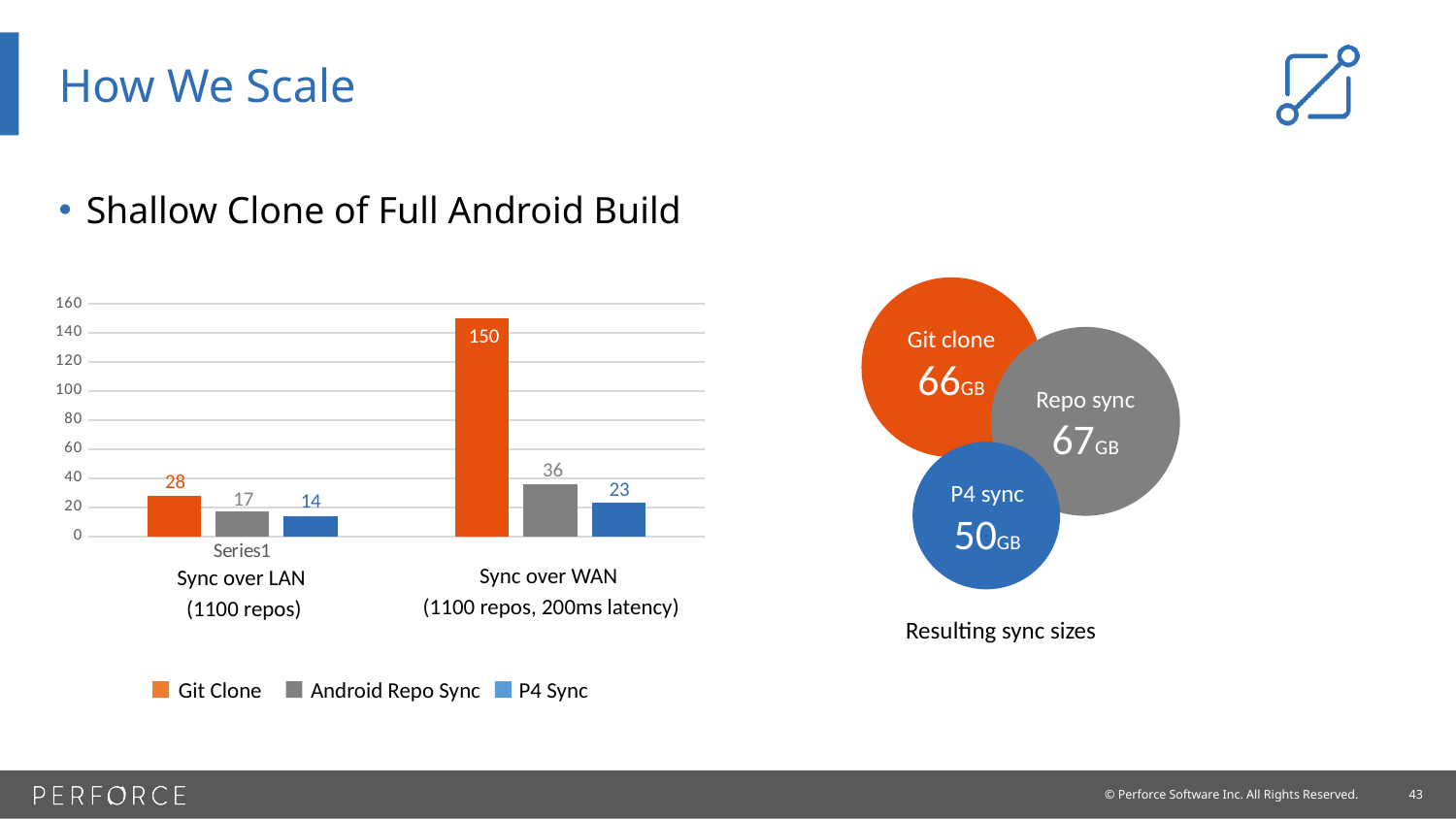
What is the P4 Sync value for Sync over LAN? 14 Which is larger for Sync over LAN: Git Clone or Android Repo Sync? Git Clone Which series has the lowest value for Sync over LAN? P4 Sync What is the difference between the Git Clone values for Sync over WAN and Sync over LAN? 122 How many series does the legend list? 3 Which series has the highest value for Sync over WAN? Git Clone What is the Android Repo Sync value for Sync over WAN? 36 What is the difference between the Android Repo Sync and P4 Sync values for Sync over WAN? 13 Is the Git Clone value for Sync over WAN greater or less than 140? greater What kind of chart is shown on the slide? Bar chart What is the Git Clone value for Sync over WAN? 150 Which colour represents P4 Sync in the chart? Blue